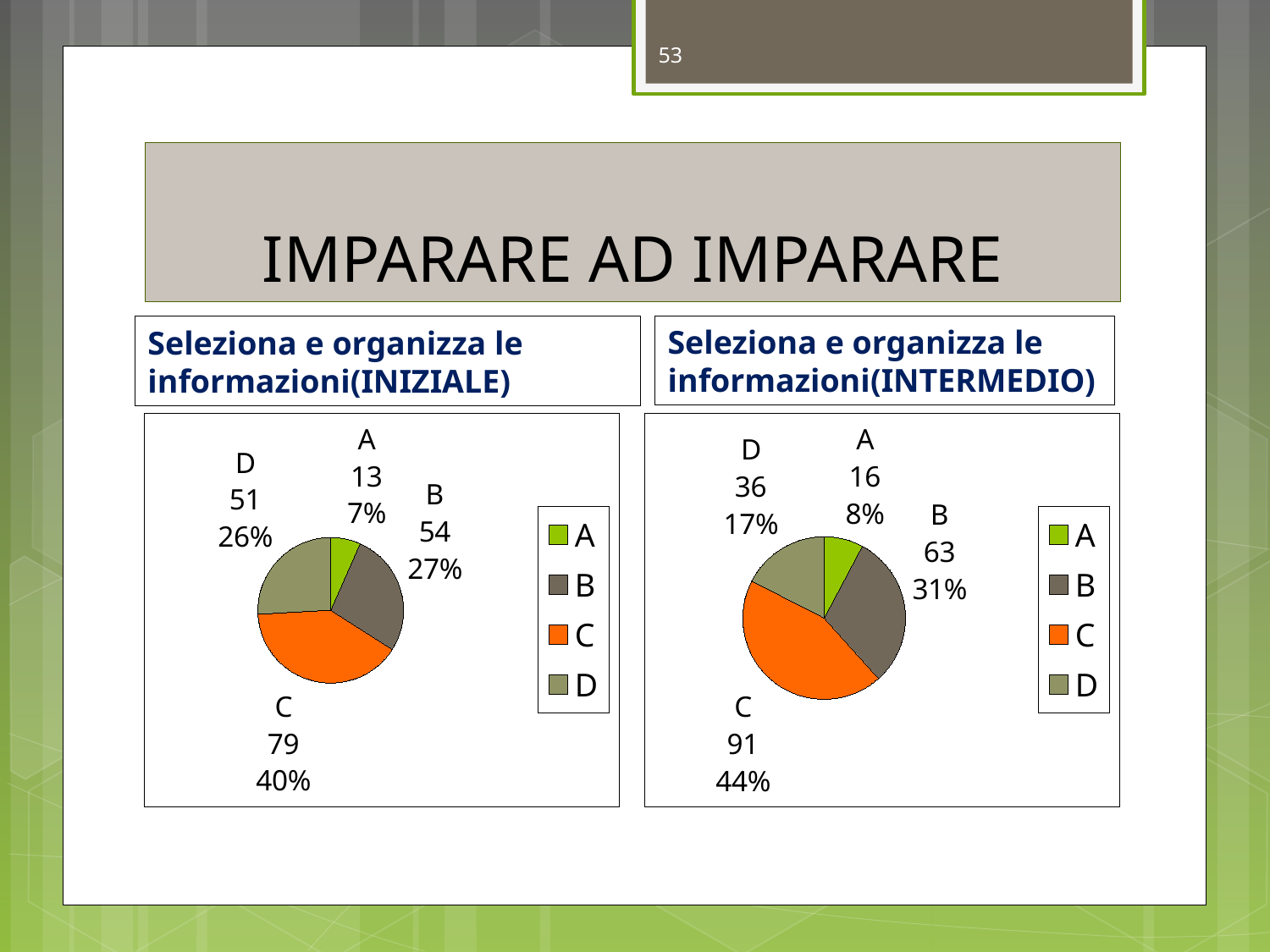
How many categories does the INIZIALE pie chart show? 4 In the INTERMEDIO pie chart, what colour is the slice for category C? Orange In the INTERMEDIO pie chart, which is larger, the value for B or the value for D? B In the INIZIALE pie chart, what is the difference between the values for D and A? 38 How many entries does the legend of the INTERMEDIO pie chart list? 4 In the INTERMEDIO pie chart, what is the value for category D? 36 In the INTERMEDIO pie chart, what percentage share does category B have? 31% What type of chart is used on the left side of the slide (INIZIALE)? Pie chart In the INTERMEDIO pie chart, which category has the smallest slice? A In the INIZIALE pie chart, what is the value for category C? 79 In the INIZIALE pie chart, what percentage share does category A have? 7% In the INIZIALE pie chart, which category has the largest slice? C